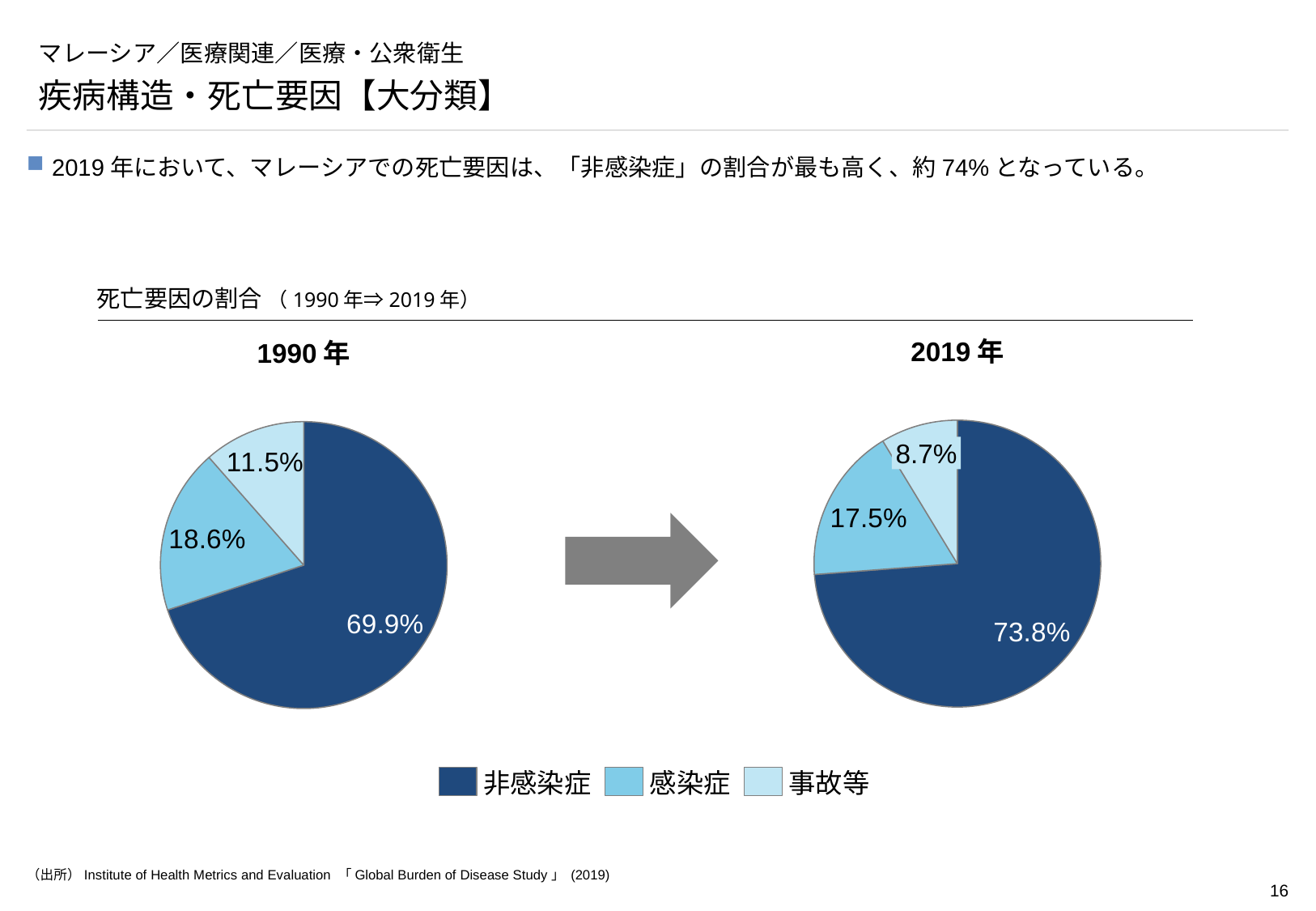
In the 1990年 pie chart, what is the share for 感染症? 18.6% In the 2019年 pie chart, which category has the largest share? 非感染症 Which colour represents 非感染症 in the legend? Dark blue In the 1990年 pie chart, what is the difference between the 感染症 share and the 事故等 share? 7.1% Which is larger: the 事故等 share in the 1990年 pie chart or in the 2019年 pie chart? 1990年 In the 2019年 pie chart, what is the share for 事故等? 8.7% What type of chart is used to show 死亡要因の割合 for 1990年 and 2019年? Pie chart In the 1990年 pie chart, which category has the smallest share? 事故等 What is the difference between the 非感染症 share in the 2019年 pie chart and in the 1990年 pie chart? 3.9% In the 1990年 pie chart, what is the share for 非感染症? 69.9% How many categories does the legend list for the pie charts? 3 In the 2019年 pie chart, what is the share for 感染症? 17.5%